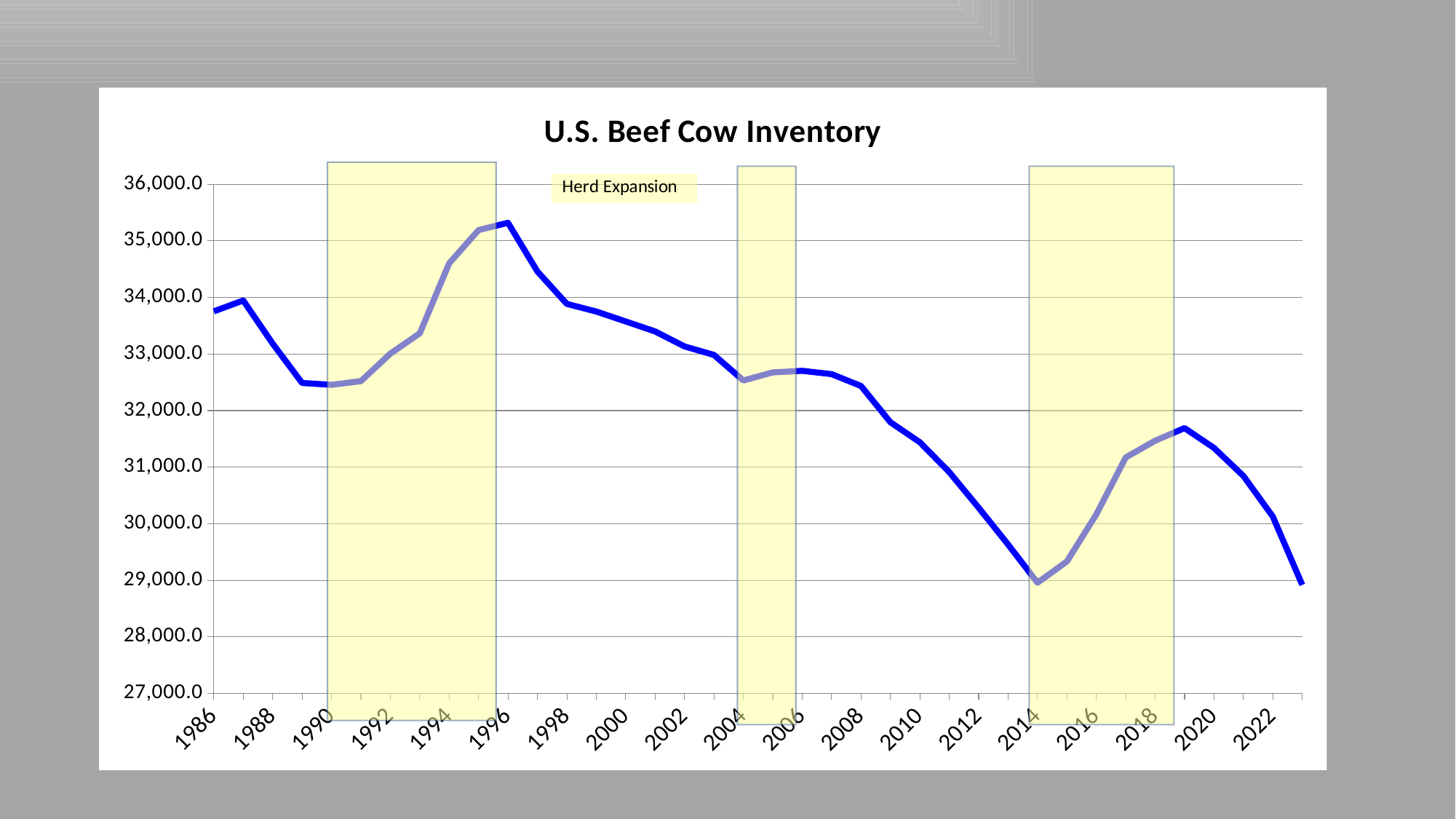
Is the value for 2000 greater or less than 33,000.0? greater In which year does the U.S. beef cow inventory reach its highest value? 1996 What kind of chart is shown on the slide? line chart Does the inventory rise or fall between 1996 and 2014? fall Is the value for 2022 greater or less than 31,000.0? less Is the value for 2010 greater or less than 32,000.0? less What is the title of the chart? U.S. Beef Cow Inventory Which year has the larger inventory, 1996 or 2014? 1996 What label is shown in the yellow annotation box near the top of the chart? Herd Expansion Does the inventory rise or fall between 2014 and 2019? rise